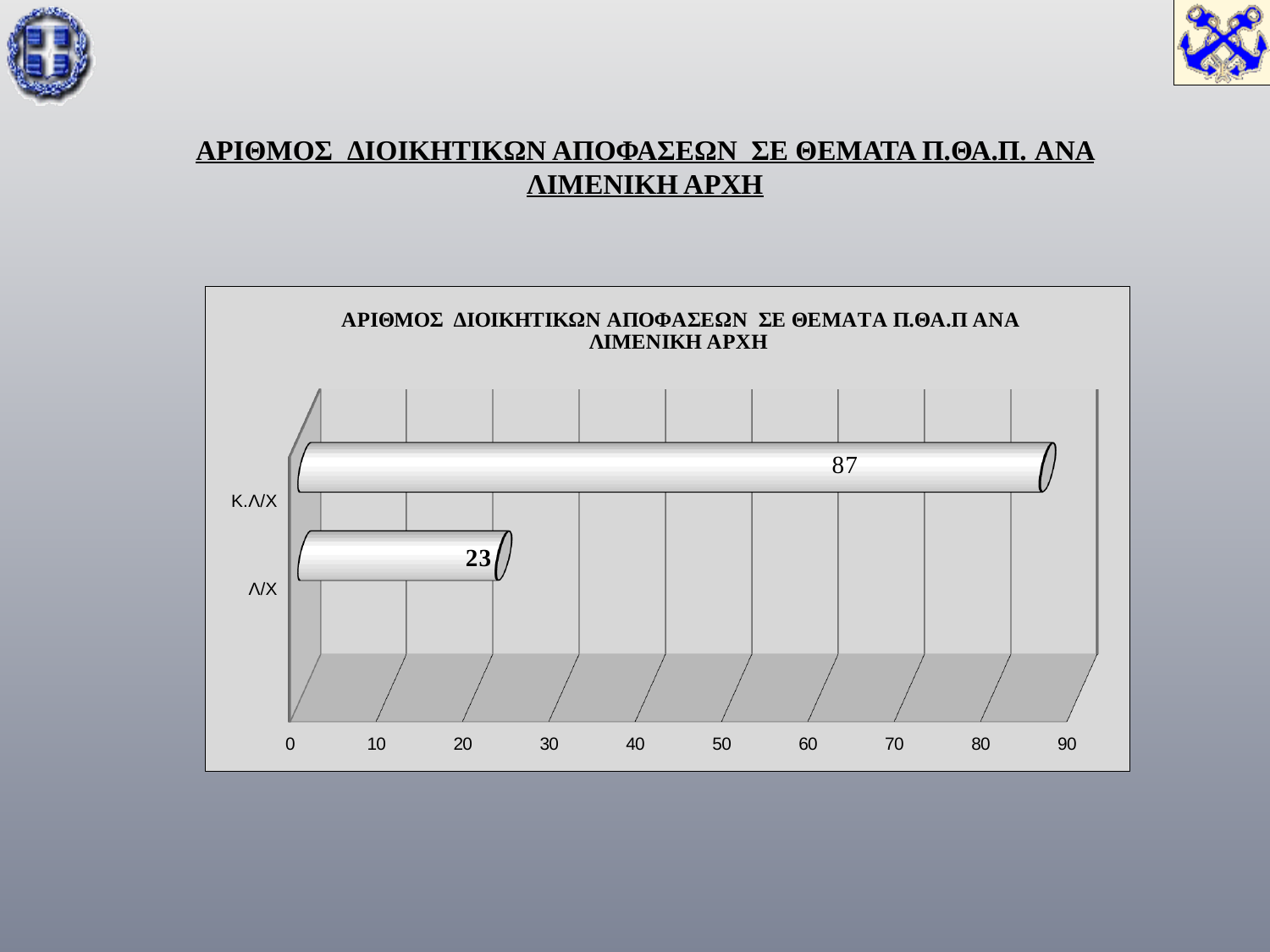
Which category has the highest value? Κ.Λ/Χ What is the title of the chart? ΑΡΙΘΜΟΣ ΔΙΟΙΚΗΤΙΚΩΝ ΑΠΟΦΑΣΕΩΝ ΣΕ ΘΕΜΑΤΑ Π.ΘΑ.Π ΑΝΑ ΛΙΜΕΝΙΚΗ ΑΡΧΗ What is the value for Κ.Λ/Χ? 87 What is the value for Λ/Χ? 23 Is the value for Κ.Λ/Χ greater or less than 80? greater What kind of chart is shown on the slide? bar chart What is the difference between the values for Κ.Λ/Χ and Λ/Χ? 64 What is the maximum value shown on the horizontal axis? 90 Is the value for Λ/Χ greater or less than 30? less How many categories are shown in the chart? 2 Which is larger, the value for Κ.Λ/Χ or the value for Λ/Χ? Κ.Λ/Χ Which category has the lowest value? Λ/Χ